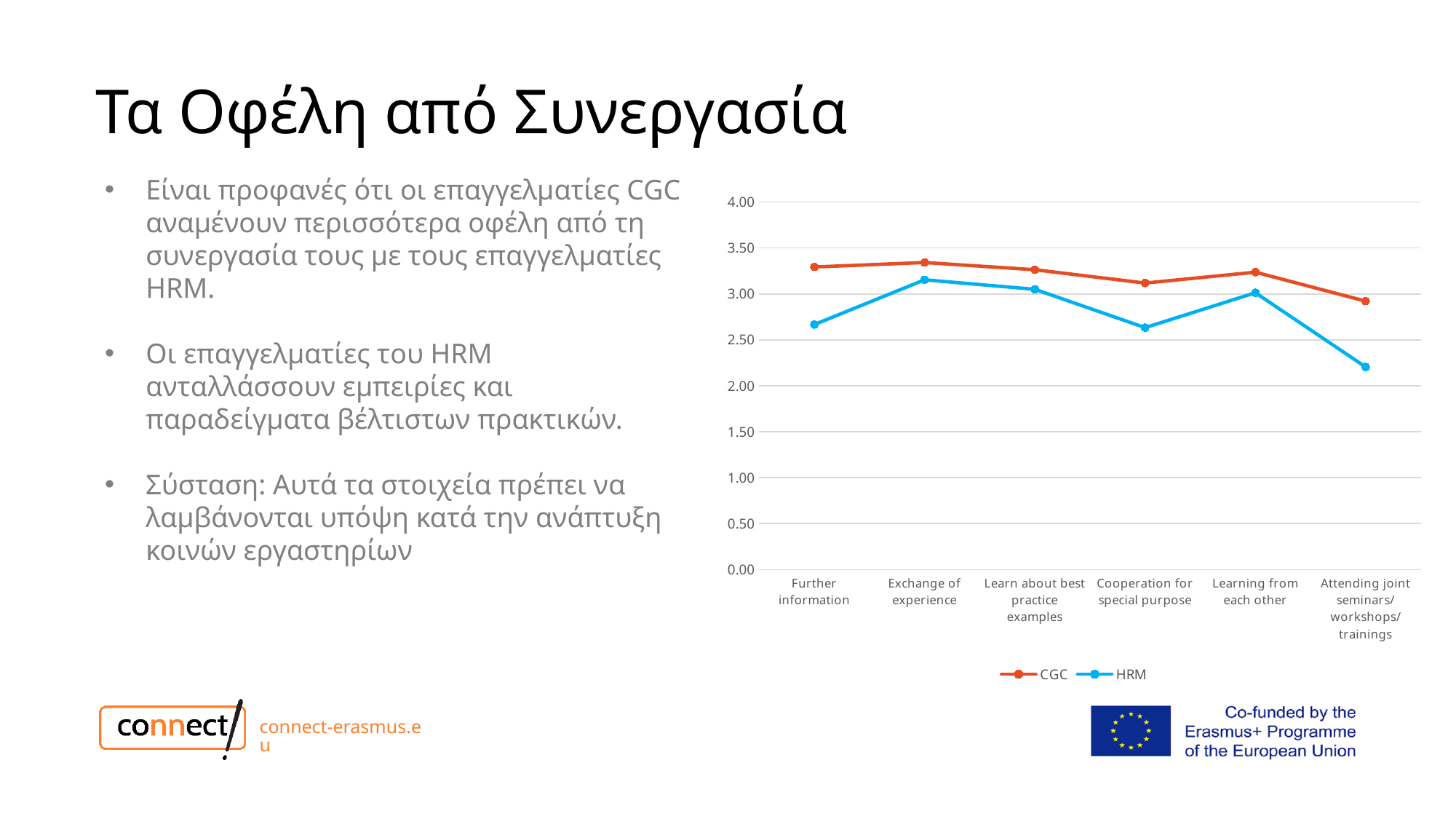
Is the HRM value for Attending joint seminars/ workshops/ trainings greater or less than 2.50? less Which series are listed in the legend? CGC and HRM Which category has the lowest HRM value? Attending joint seminars/ workshops/ trainings Is the CGC value for Further information greater or less than 3.00? greater Which category has the highest HRM value? Exchange of experience Does the HRM line rise or fall from Learning from each other to Attending joint seminars/ workshops/ trainings? fall How many series does the legend list? 2 Which category has the lowest CGC value? Attending joint seminars/ workshops/ trainings For Further information, which series has the larger value, CGC or HRM? CGC Is the HRM value for Further information greater or less than 2.50? greater What kind of chart is shown on the slide? line chart How many categories are shown on the x axis? 6